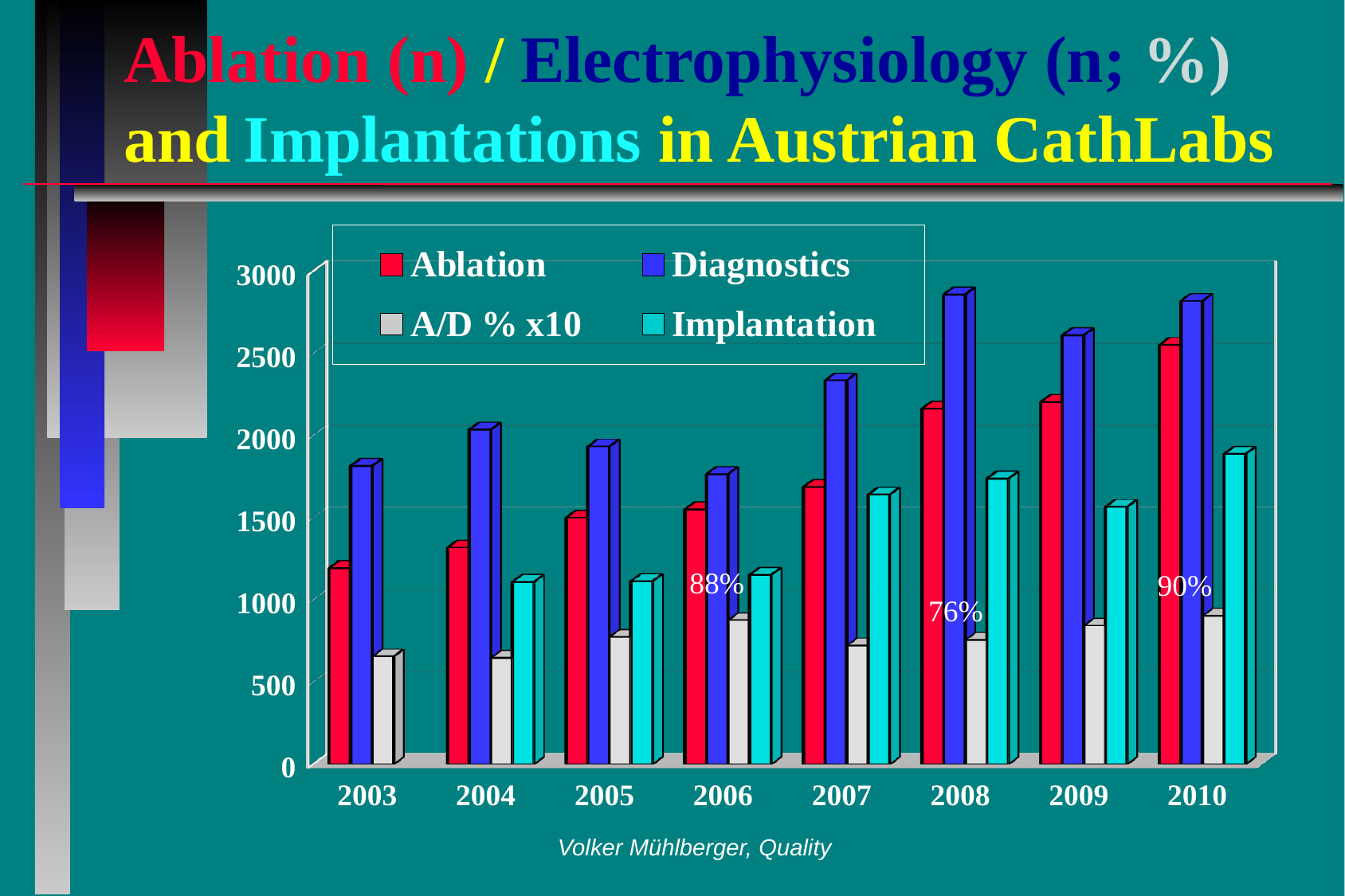
What percentage label is printed for 2010? 90% Is the Ablation value for 2003 greater or less than 1500? less What percentage label is printed for 2008? 76% How many series does the legend list? 4 In 2006, which is larger: Ablation or Diagnostics? Diagnostics What percentage label is printed for 2006? 88% What kind of chart is shown on the slide? bar chart In which year is the Diagnostics value lowest? 2003 In which year is the Ablation value highest? 2010 How many years are shown on the x axis? 8 Does the Ablation value generally rise or fall from 2003 to 2010? rise Is the Diagnostics value for 2007 greater or less than 2000? greater